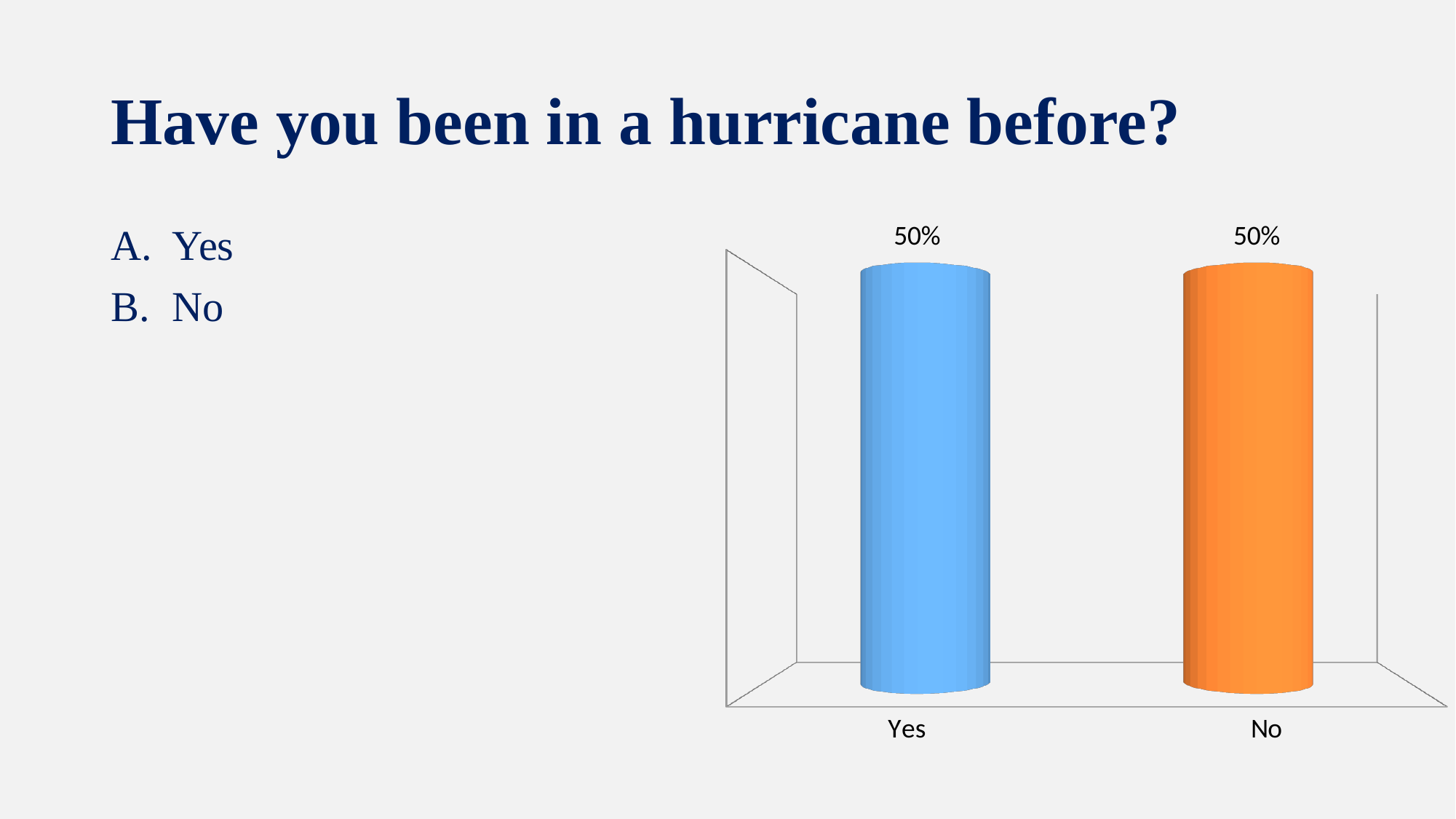
What is the difference between the values for Yes and No? 0% What kind of chart is shown on the slide? bar chart What colour is the bar for Yes? blue Are the values for Yes and No equal? Yes What is the value for No? 50% How many categories are shown on the chart? 2 What colour is the bar for No? orange What is the value for Yes? 50% What is the total of the values for Yes and No? 100%